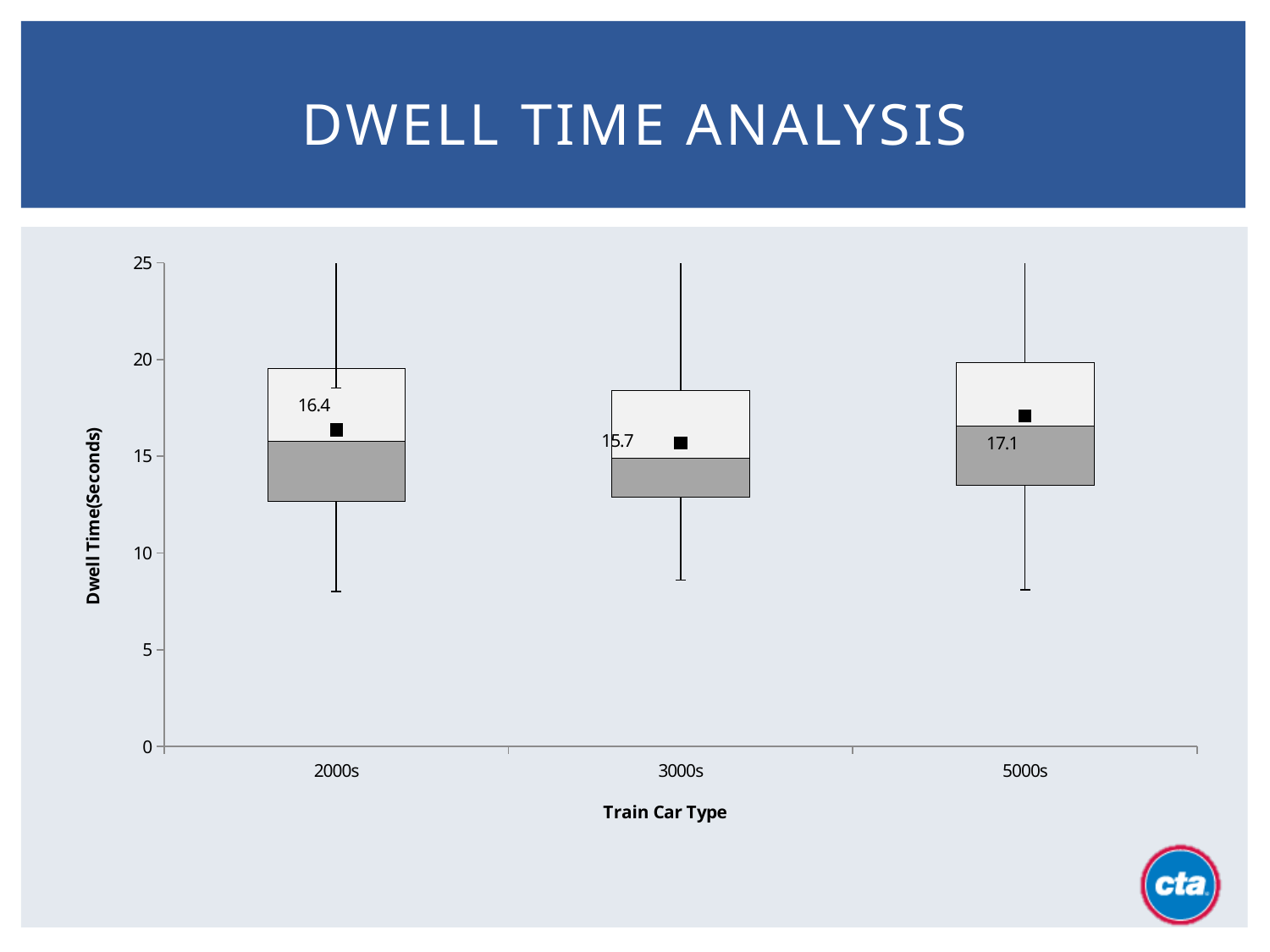
What is the difference between the labelled mean dwell times of the 2000s and 3000s train car types? 0.7 How many train car types are shown on the x axis? 3 Which train car type has the highest labelled mean dwell time? 5000s Which has a larger labelled mean dwell time, the 2000s or the 3000s train car type? 2000s Which train car type has the lowest labelled mean dwell time? 3000s Is the bottom of the lower whisker for the 5000s train car type greater or less than 10 seconds? less What is the labelled mean dwell time for the 5000s train car type? 17.1 What kind of chart is shown on the slide? Box plot What is the labelled mean dwell time for the 3000s train car type? 15.7 What is the difference between the labelled mean dwell times of the 5000s and 3000s train car types? 1.4 Is the top of the upper whisker for the 2000s train car type greater or less than 20 seconds? greater What is the labelled mean dwell time for the 2000s train car type? 16.4